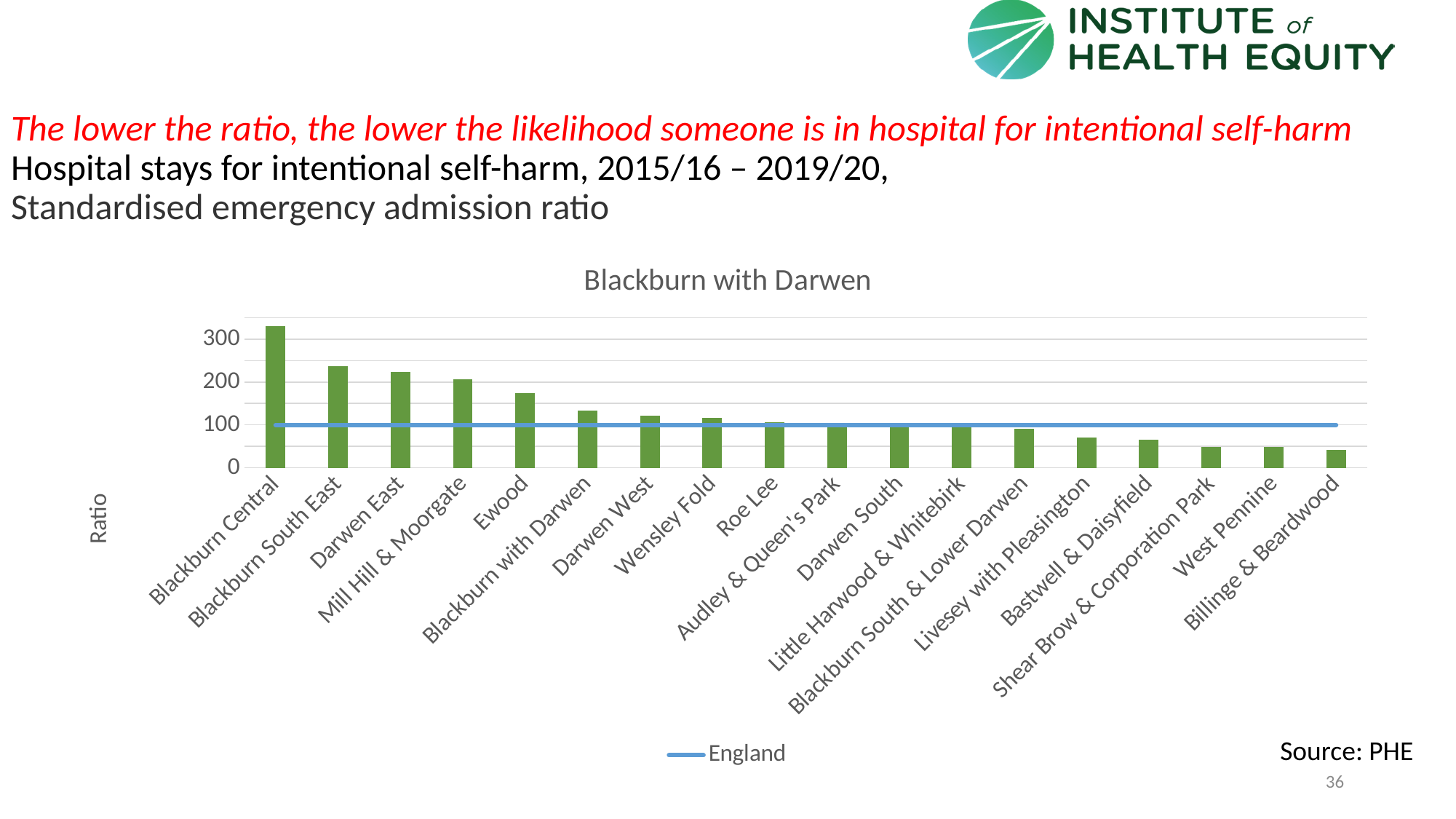
Do the bar values rise or fall moving from left to right along the x axis? fall At what value does the England reference line sit on the y axis? 100 What kind of chart is shown on the slide? Combination bar and line chart (bars with an England reference line) Is the value for Livesey with Pleasington greater or less than 100? less Is the value for Ewood greater or less than 100? greater Is the value for Blackburn Central greater or less than 300? greater What is the title of the chart? Blackburn with Darwen Which ward has the highest standardised emergency admission ratio? Blackburn Central How many entries does the chart legend list? 1 Which has the larger value, Darwen East or Ewood? Darwen East How many wards (bars) are plotted in the chart? 18